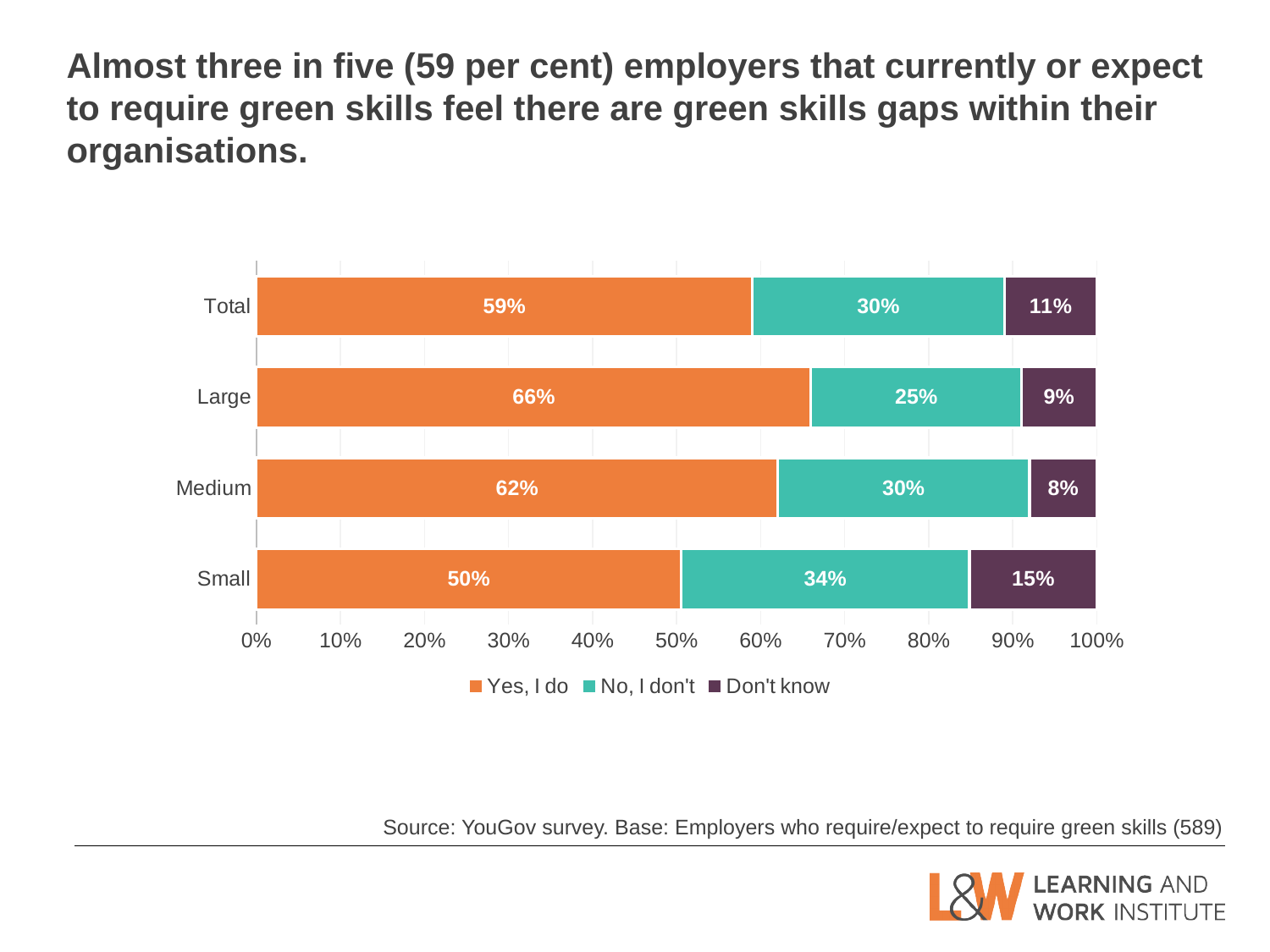
Which category has the highest "Yes, I do" share? Large What kind of chart is shown on the slide? Stacked bar chart Is the "Yes, I do" value for Medium employers greater or less than 50%? greater What is the difference between the "Yes, I do" values for Large and Small employers? 16 percentage points How many series does the legend list? 3 Which legend entry is shown in orange? Yes, I do Which category has the lowest "Yes, I do" share? Small Which is larger: the "No, I don't" value for Small or for Large? Small What percentage of Large employers answered "Yes, I do"? 66% How many categories are shown on the y axis? 4 What is the "No, I don't" value for Medium employers? 30% What percentage of Small employers answered "Don't know"? 15%